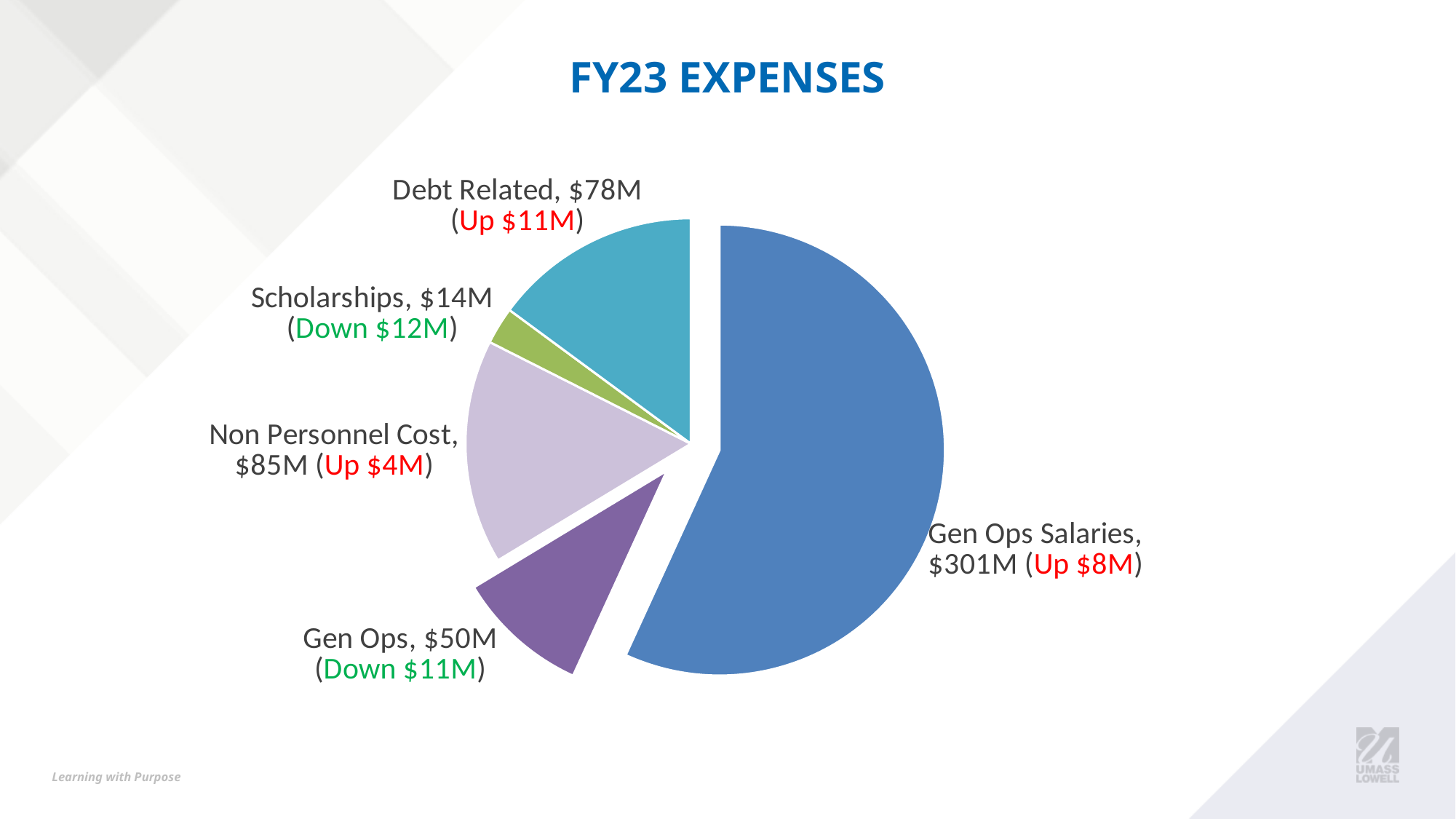
What is the title of the chart? FY23 EXPENSES What type of chart is shown on the slide? Pie chart Which is larger, Debt Related or Gen Ops? Debt Related What is the difference between Non Personnel Cost and Gen Ops? $35M What is the value for Gen Ops Salaries? $301M What is the value for Non Personnel Cost? $85M What is the value for Debt Related expenses? $78M By how much did Scholarships change according to the label? Down $12M What is the total of all expense categories shown in the pie chart? $528M Which category has the smallest expense? Scholarships Which category has the largest expense? Gen Ops Salaries How many slices does the pie chart have? 5